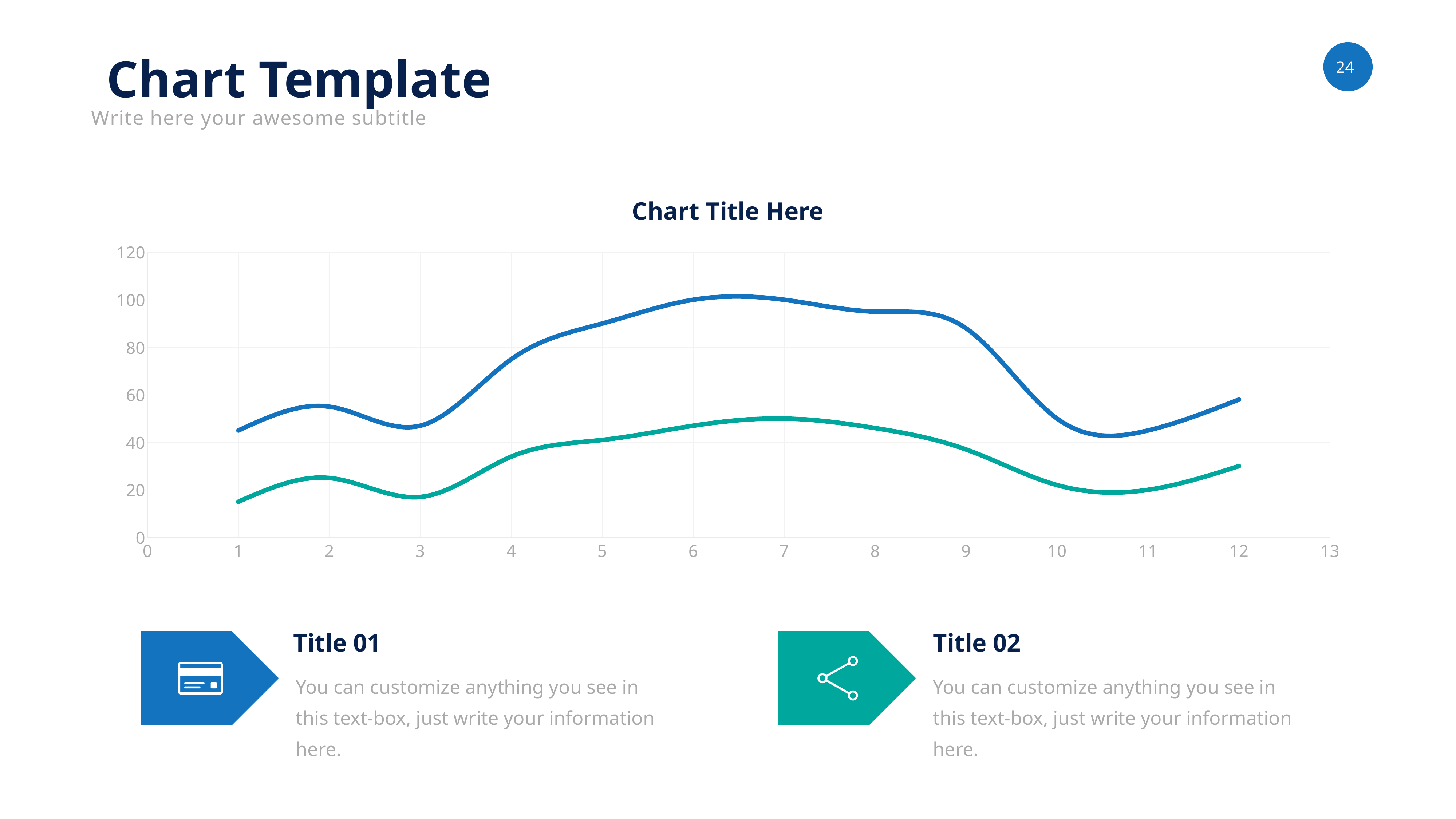
How many lines are plotted on the chart? 2 What is the title of the chart? Chart Title Here Does the blue line rise or fall between x = 9 and x = 11? fall What kind of chart is shown on the slide? line chart Is the value of the blue line at x = 11 greater or less than 60? less Is the value of the teal line at x = 10 greater or less than 40? less Does the blue line rise or fall between x = 3 and x = 6? rise Is the value of the teal line at x = 7 greater or less than 60? less At x = 6, which line has the larger value, the blue line or the teal line? the blue line What is the highest value shown on the y axis? 120